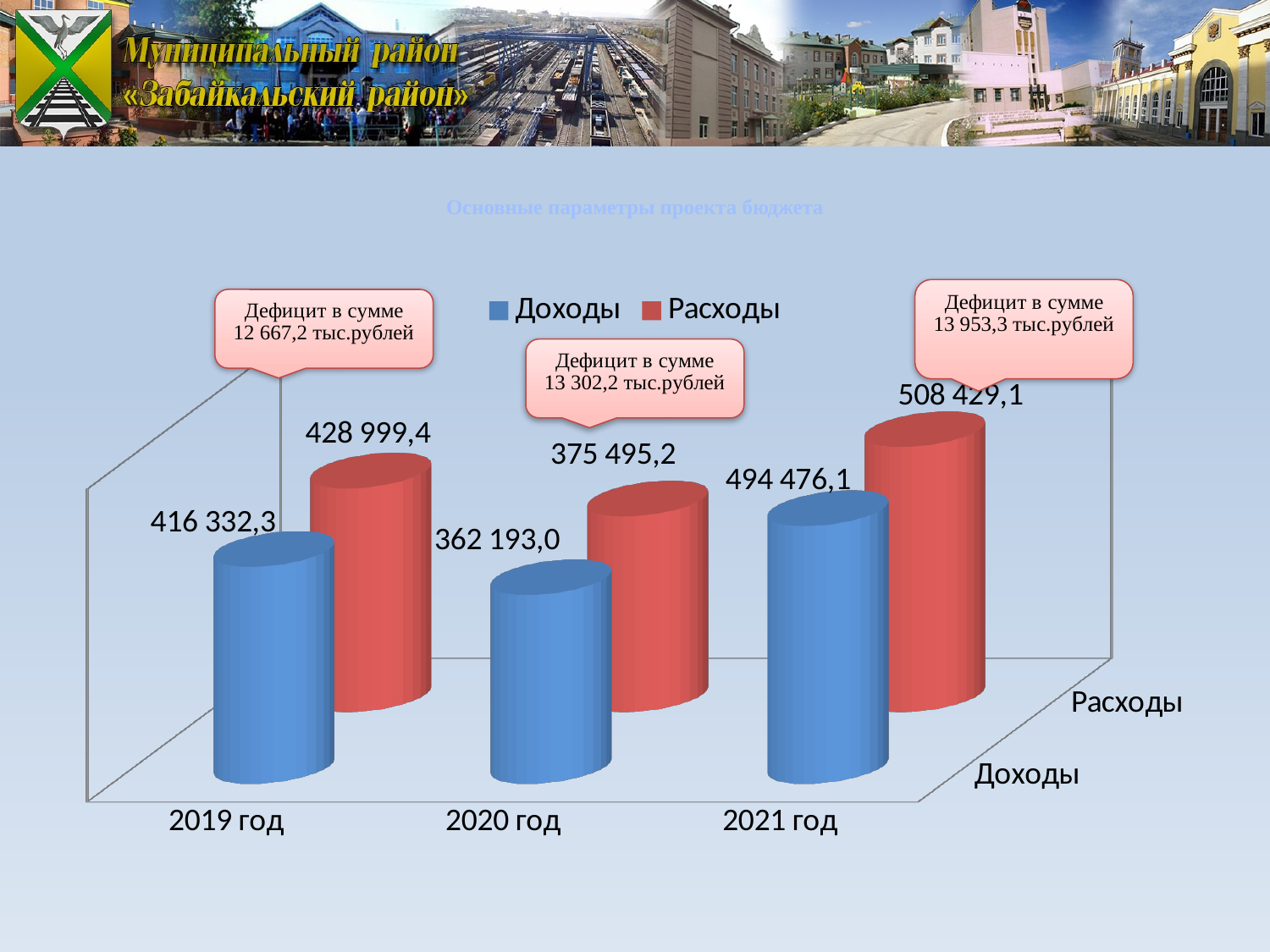
What is the difference between Расходы and Доходы in 2020 год? 13 302,2 In which year is Доходы the lowest? 2020 год What is the value of Доходы for 2020 год? 362 193,0 In which year is Доходы the highest? 2021 год How many series does the legend list? 2 Which is larger in 2019 год, Доходы or Расходы? Расходы What is the value of Расходы for 2019 год? 428 999,4 How many years (categories) are shown on the x axis? 3 What is the value of Расходы for 2020 год? 375 495,2 What is the value of Доходы for 2019 год? 416 332,3 What kind of chart is shown on the slide? bar chart What is the value of Доходы for 2021 год? 494 476,1